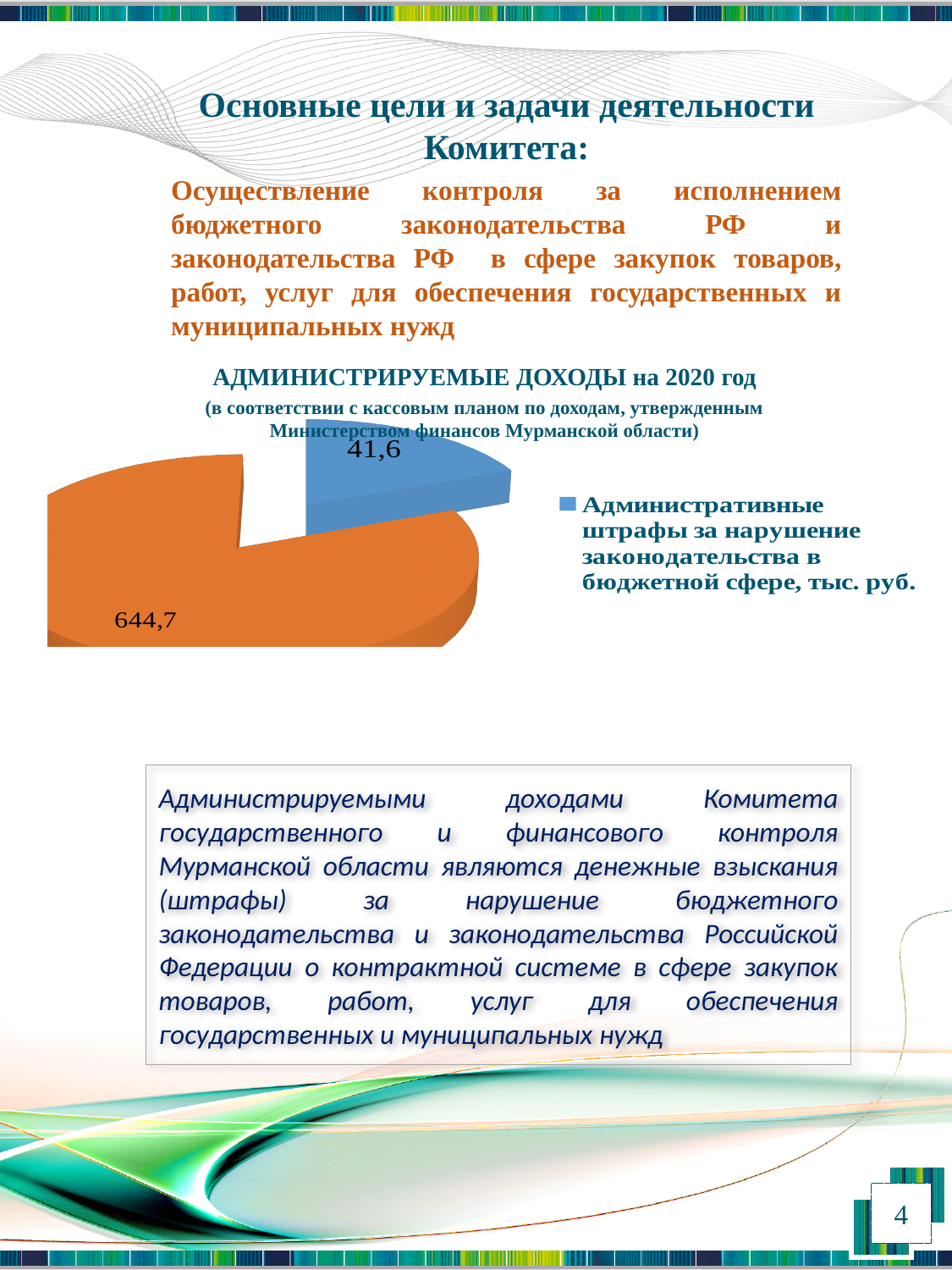
Which slice of the pie chart is the smallest? The blue slice (41,6) How many slices does the pie chart have? 2 Which is larger, the orange slice or the blue slice? The orange slice How many entries does the legend of the pie chart list? 1 Which slice of the pie chart is the largest? The orange slice (644,7) What kind of chart is shown on the slide? Pie chart What value is printed on the blue slice of the pie chart? 41,6 What is the difference between the orange slice value (644,7) and the blue slice value (41,6)? 603,1 What is the value of the slice labelled in the legend as 'Административные штрафы за нарушение законодательства в бюджетной сфере, тыс. руб.'? 41,6 What is the total of the two slice values shown on the pie chart? 686,3 What is the title printed above the pie chart? АДМИНИСТРИРУЕМЫЕ ДОХОДЫ на 2020 год What value is printed on the orange slice of the pie chart? 644,7